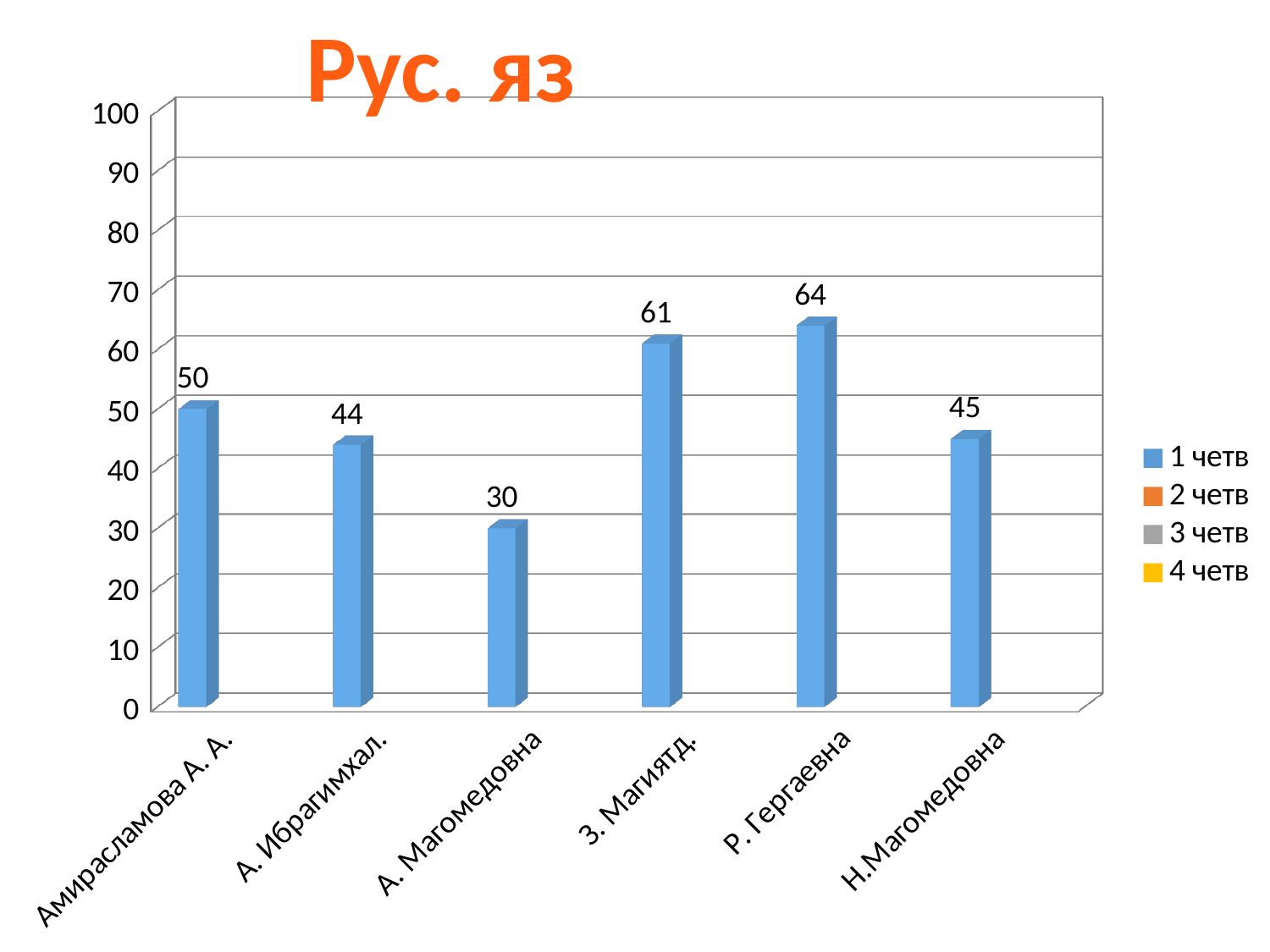
What is the difference between the values for З. Магиятд. and А. Ибрагимхал.? 17 Is the value for З. Магиятд. greater or less than 50? greater Which category has the lowest value? А. Магомедовна How many series does the legend list? 4 What kind of chart is shown on the slide? bar chart What is the value for Амирасламова А. А. in the 1 четв series? 50 What is the value for Р. Гергаевна? 64 How many categories are shown on the x axis? 6 What is the title of the chart? Рус. яз Which category has the highest value? Р. Гергаевна What is the value for А. Магомедовна? 30 Which is larger, the value for Н.Магомедовна or the value for А. Ибрагимхал.? Н.Магомедовна